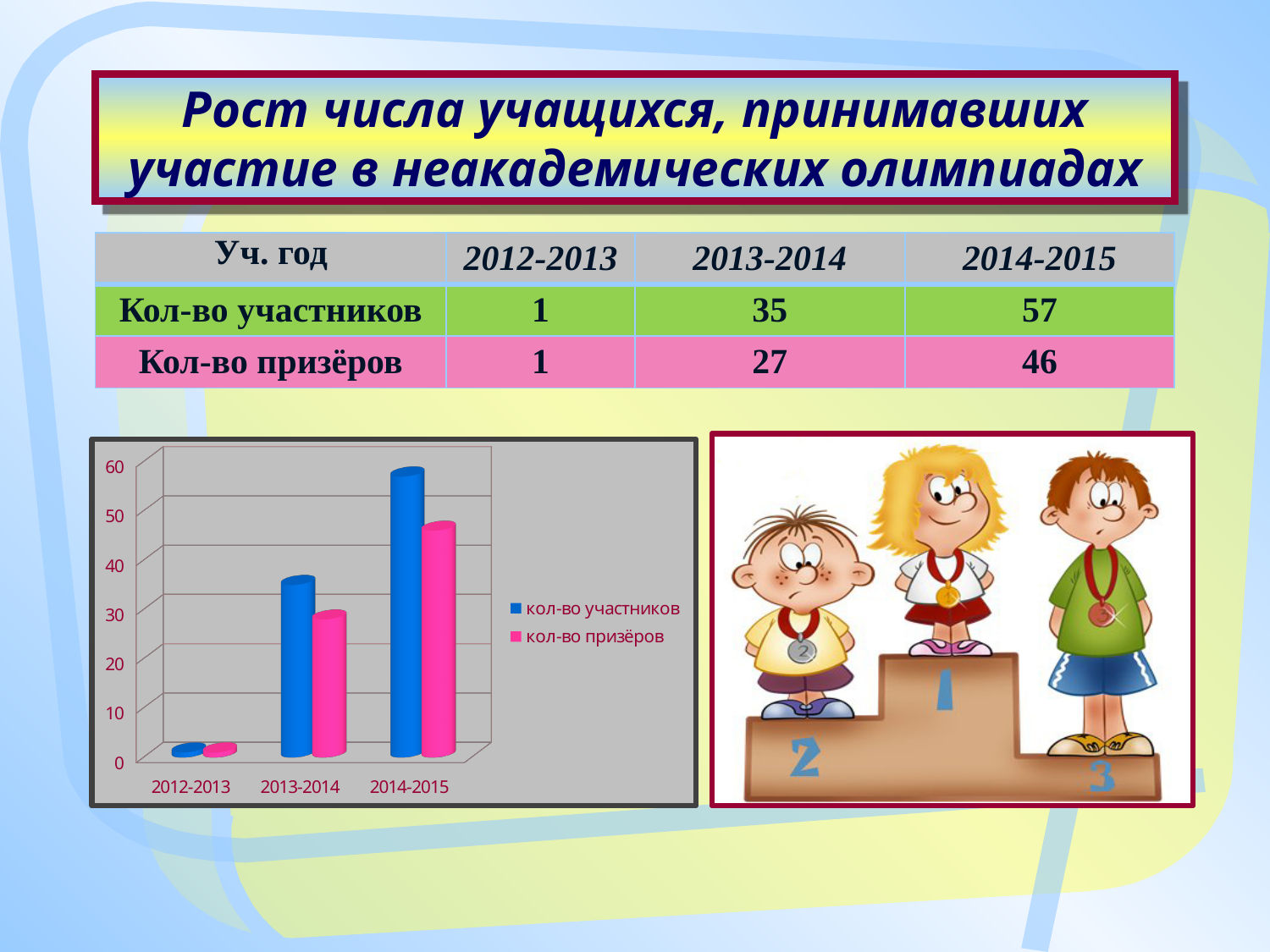
What kind of chart is shown on the slide? bar chart What is the number of participants (кол-во участников) for 2014-2015? 57 Is the value for кол-во участников in 2014-2015 greater or less than 50? greater How many academic years are shown on the x axis of the chart? 3 Do the values for кол-во участников rise or fall from 2012-2013 to 2014-2015? rise Which is larger in 2013-2014: the number of participants or the number of prize-winners? кол-во участников Which year has the highest number of participants (кол-во участников)? 2014-2015 What colour are the bars for кол-во призёров in the chart? pink What is the number of prize-winners (кол-во призёров) for 2013-2014? 27 How many series does the chart legend list? 2 What is the difference between the number of participants and the number of prize-winners in 2014-2015? 11 Which year has the lowest number of prize-winners (кол-во призёров)? 2012-2013